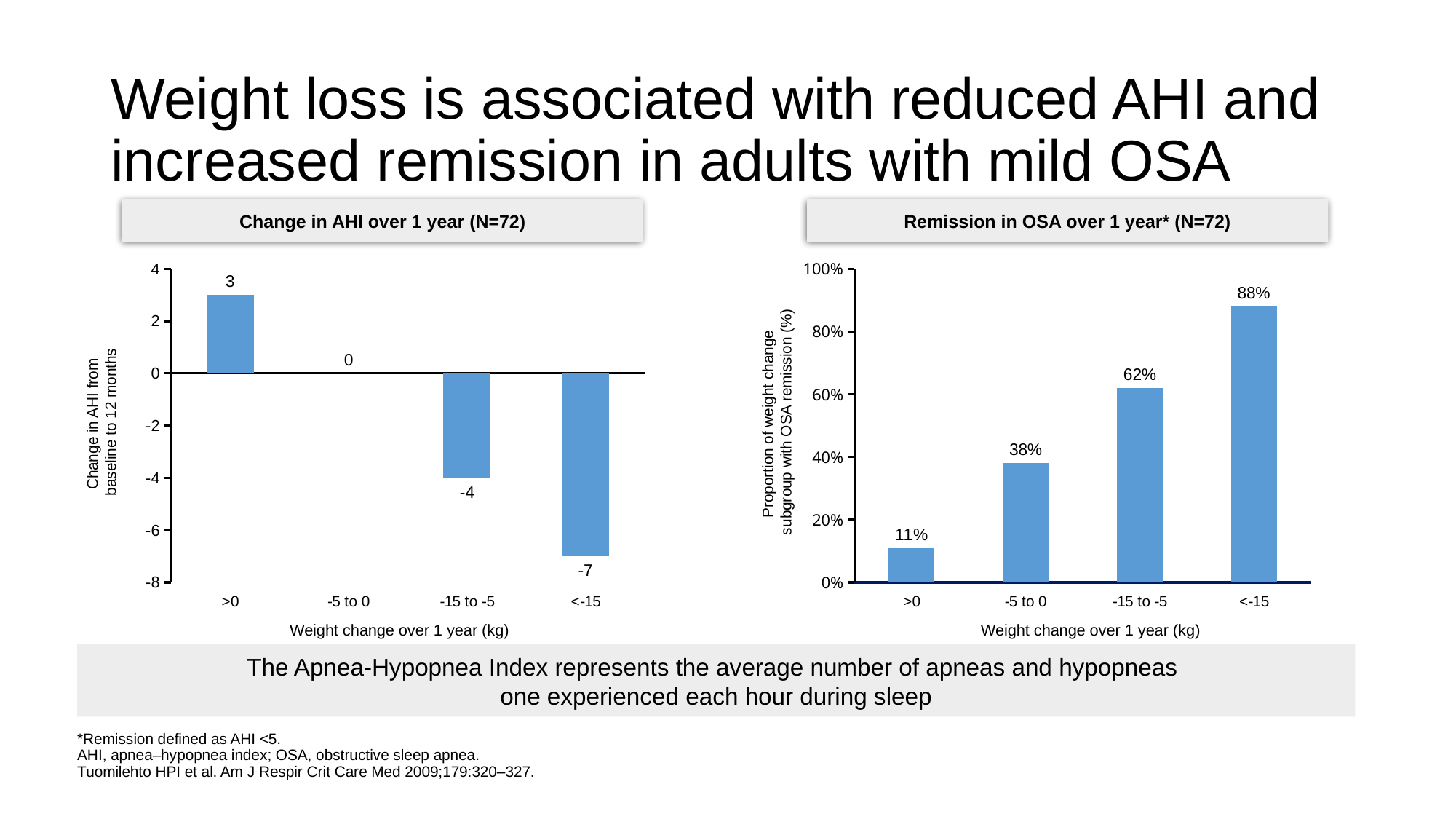
In the 'Remission in OSA over 1 year* (N=72)' chart, what is the difference between the remission proportions for '<-15' and '-5 to 0'? 50% In the 'Change in AHI over 1 year (N=72)' chart, how many weight change categories are shown on the x axis? 4 In the 'Remission in OSA over 1 year* (N=72)' chart, which weight change group has the lowest remission proportion? >0 In the 'Change in AHI over 1 year (N=72)' chart, which weight change group has the lowest change in AHI? <-15 In the 'Change in AHI over 1 year (N=72)' chart, what is the change in AHI for the '>0' weight change group? 3 In the 'Change in AHI over 1 year (N=72)' chart, what is the difference between the values for '>0' and '-15 to -5'? 7 In the 'Remission in OSA over 1 year* (N=72)' chart, which weight change group has the highest remission proportion? <-15 In the 'Remission in OSA over 1 year* (N=72)' chart, what proportion of the '-15 to -5' subgroup had OSA remission? 62% In the 'Change in AHI over 1 year (N=72)' chart, what is the change in AHI for the '<-15' weight change group? -7 What kind of chart is the 'Remission in OSA over 1 year* (N=72)' chart? bar chart In the 'Change in AHI over 1 year (N=72)' chart, do the values rise or fall from left to right along the x axis? fall In the 'Remission in OSA over 1 year* (N=72)' chart, which is larger: the value for '-5 to 0' or the value for '>0'? -5 to 0